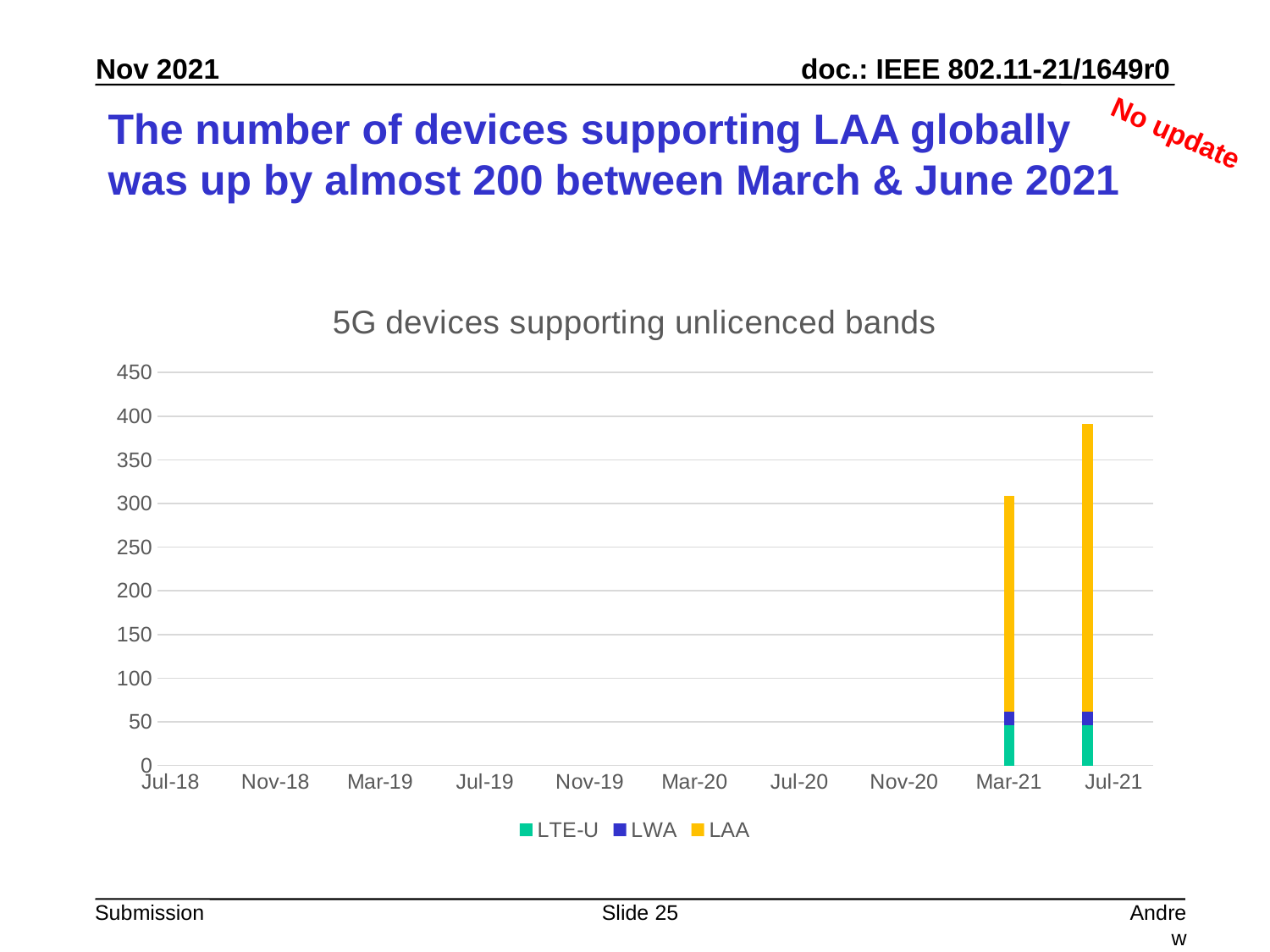
Is the total height of the Jul-21 bar greater or less than 450? less Is the total height of the Mar-21 bar greater or less than 250? greater How many date labels are shown along the x axis? 10 Which series makes up the largest part of the Jul-21 bar? LAA Which series are listed in the chart's legend? LTE-U, LWA, LAA How many bars are plotted in the chart? 2 Do the bar totals rise or fall from Mar-21 to Jul-21? Rise How many series does the chart's legend list? 3 Is the total height of the Jul-21 bar greater or less than 350? greater What kind of chart is shown on the slide? Stacked bar chart What is the title of the chart? 5G devices supporting unlicenced bands Which bar is taller in total, Mar-21 or Jul-21? Jul-21